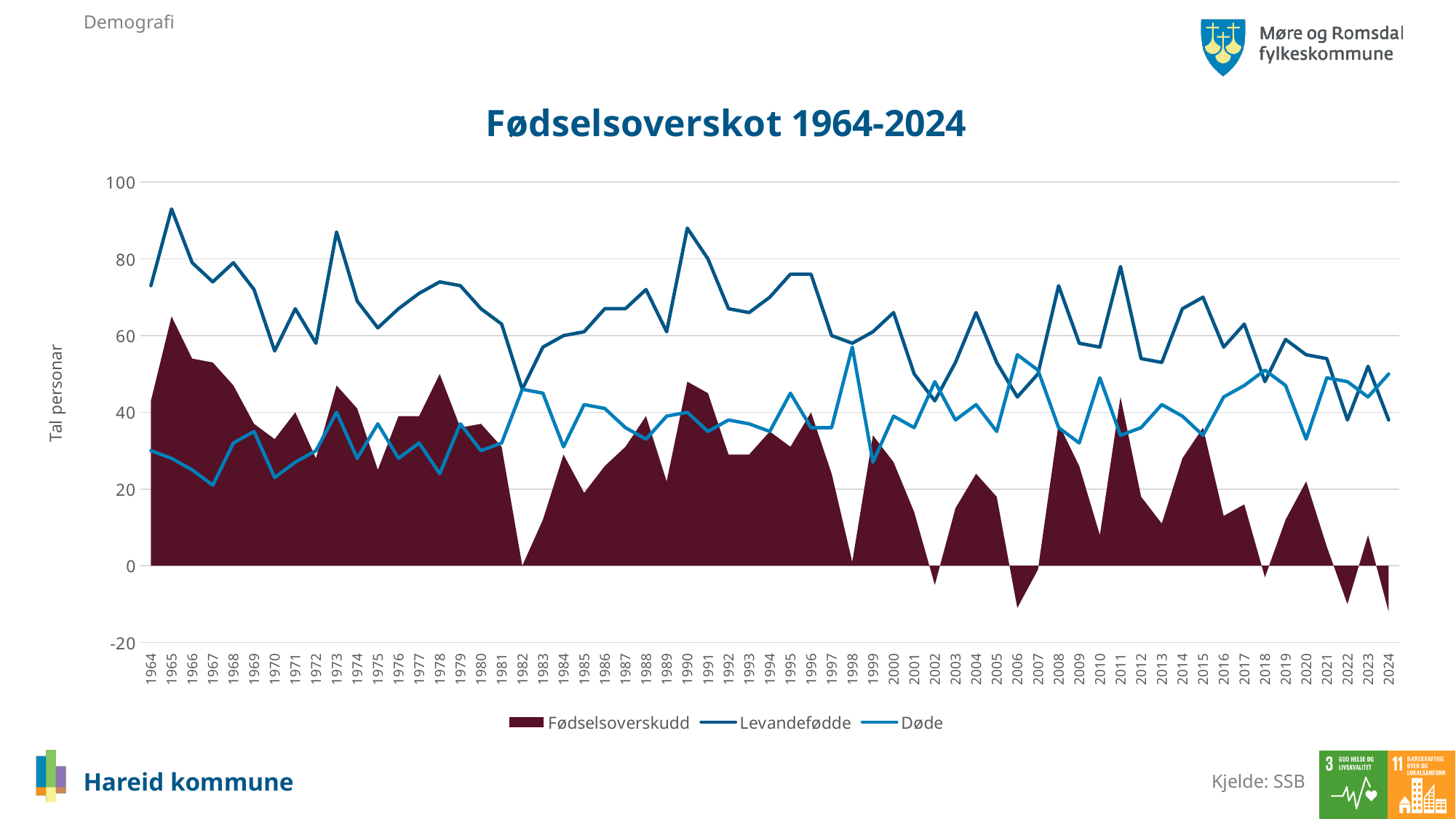
Is the value for Levandefødde in 1982 greater or less than 60? less Is the value for Fødselsoverskudd in 2006 greater or less than 0? less How many years are plotted along the x axis? 61 Is the Levandefødde series drawn as a line or as bars? line What is the label on the vertical axis? Tal personar In which year does the Levandefødde series reach its highest value? 1965 Is the value for Døde in 1967 greater or less than 30? less What is the title of the chart? Fødselsoverskot 1964-2024 How many series does the legend list? 3 In 2024, which is larger: Levandefødde or Døde? Døde Does the Levandefødde series overall rise or fall from 1964 to 2024? fall